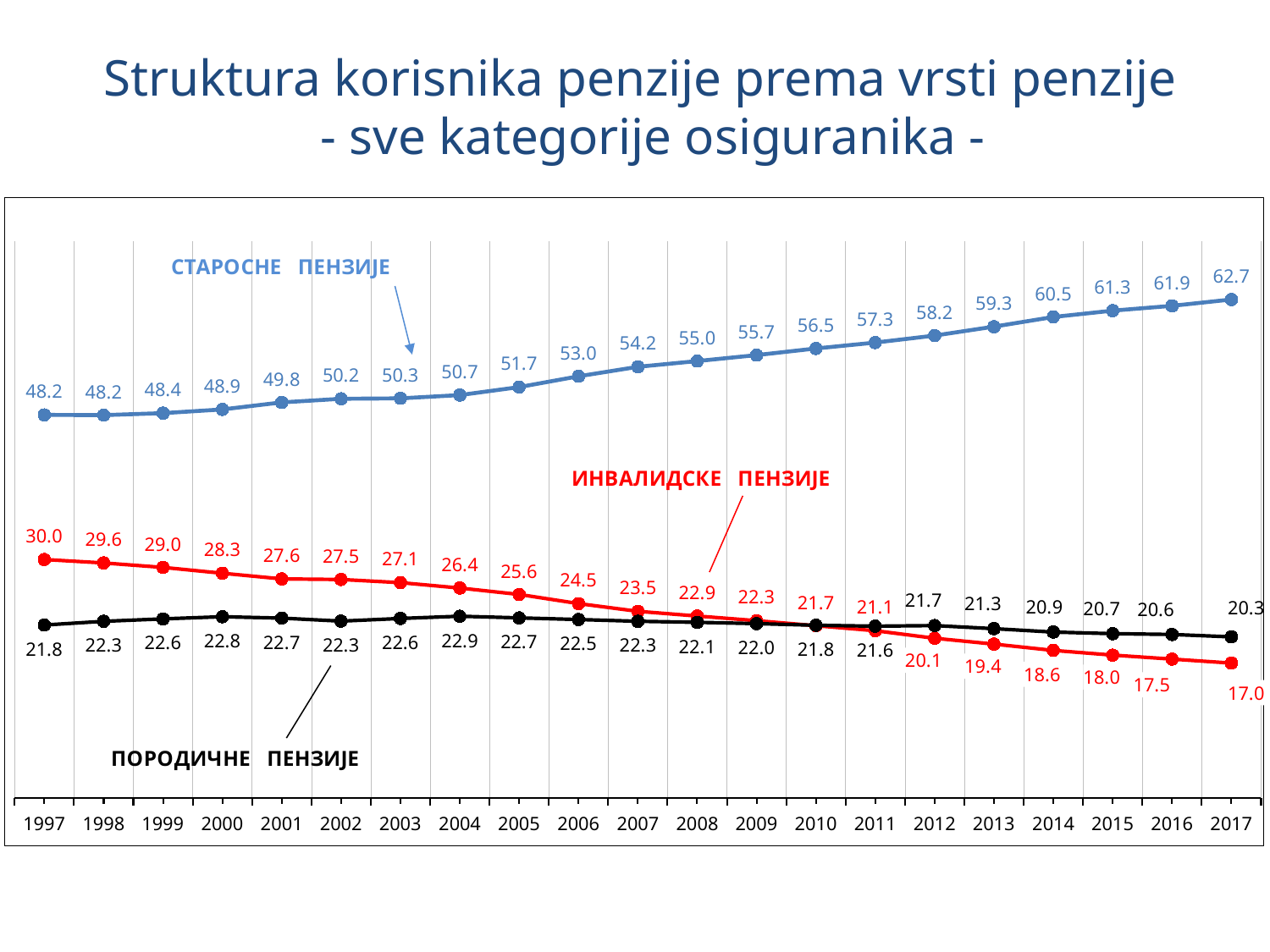
In which year is the value for СТАРОСНЕ ПЕНЗИЈЕ highest? 2017 What type of chart is shown on the slide? line chart How many years are shown on the x axis? 21 What is the value for СТАРОСНЕ ПЕНЗИЈЕ in 2017? 62.7 Does the value for ИНВАЛИДСКЕ ПЕНЗИЈЕ rise or fall from 1997 to 2017? fall What is the difference between the ИНВАЛИДСКЕ ПЕНЗИЈЕ values in 1997 and 2017? 13.0 What is the value for ПОРОДИЧНЕ ПЕНЗИЈЕ in 2004? 22.9 Which is larger in 2012: ПОРОДИЧНЕ ПЕНЗИЈЕ or ИНВАЛИДСКЕ ПЕНЗИЈЕ? ПОРОДИЧНЕ ПЕНЗИЈЕ How many series are plotted on the chart? 3 In which year is the value for ИНВАЛИДСКЕ ПЕНЗИЈЕ lowest? 2017 What is the value for ИНВАЛИДСКЕ ПЕНЗИЈЕ in 1997? 30.0 What is the difference between the СТАРОСНЕ ПЕНЗИЈЕ values in 2017 and 1997? 14.5